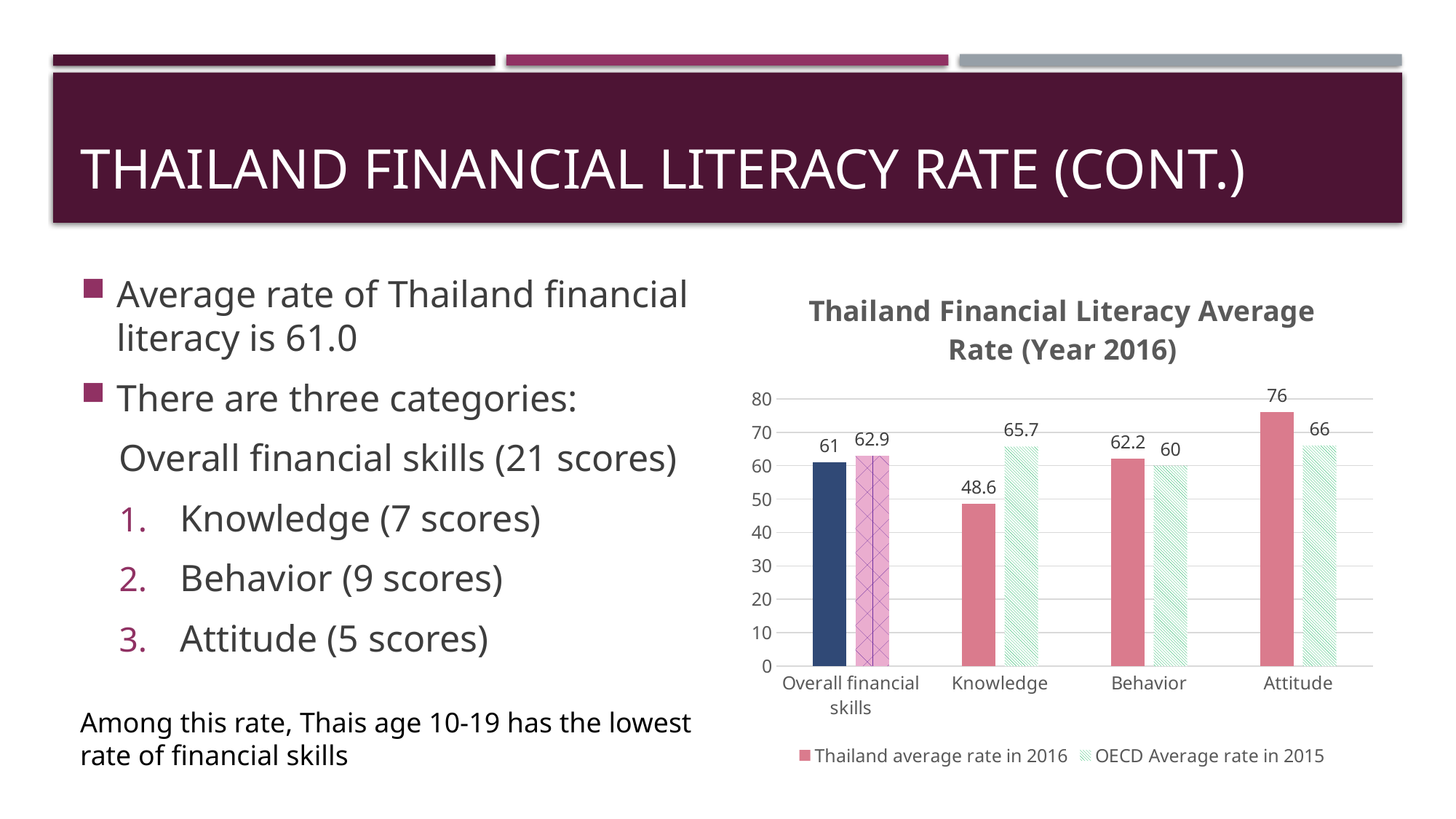
For Behavior, which is larger: the Thailand average rate in 2016 or the OECD average rate in 2015? Thailand average rate in 2016 Which category has the lowest Thailand average rate in 2016? Knowledge How many categories are shown on the x axis of the chart? 4 What is the OECD average rate in 2015 for Attitude? 66 What is the Thailand average rate in 2016 for Knowledge? 48.6 What is the difference between the OECD average rate in 2015 and the Thailand average rate in 2016 for Knowledge? 17.1 What is the Thailand average rate in 2016 for Overall financial skills? 61 What kind of chart is shown on the slide? Bar chart How many series does the chart legend list? 2 Is the Thailand average rate in 2016 for Attitude greater or less than 70? greater Which category has the highest Thailand average rate in 2016? Attitude What is the title of the chart? Thailand Financial Literacy Average Rate (Year 2016)